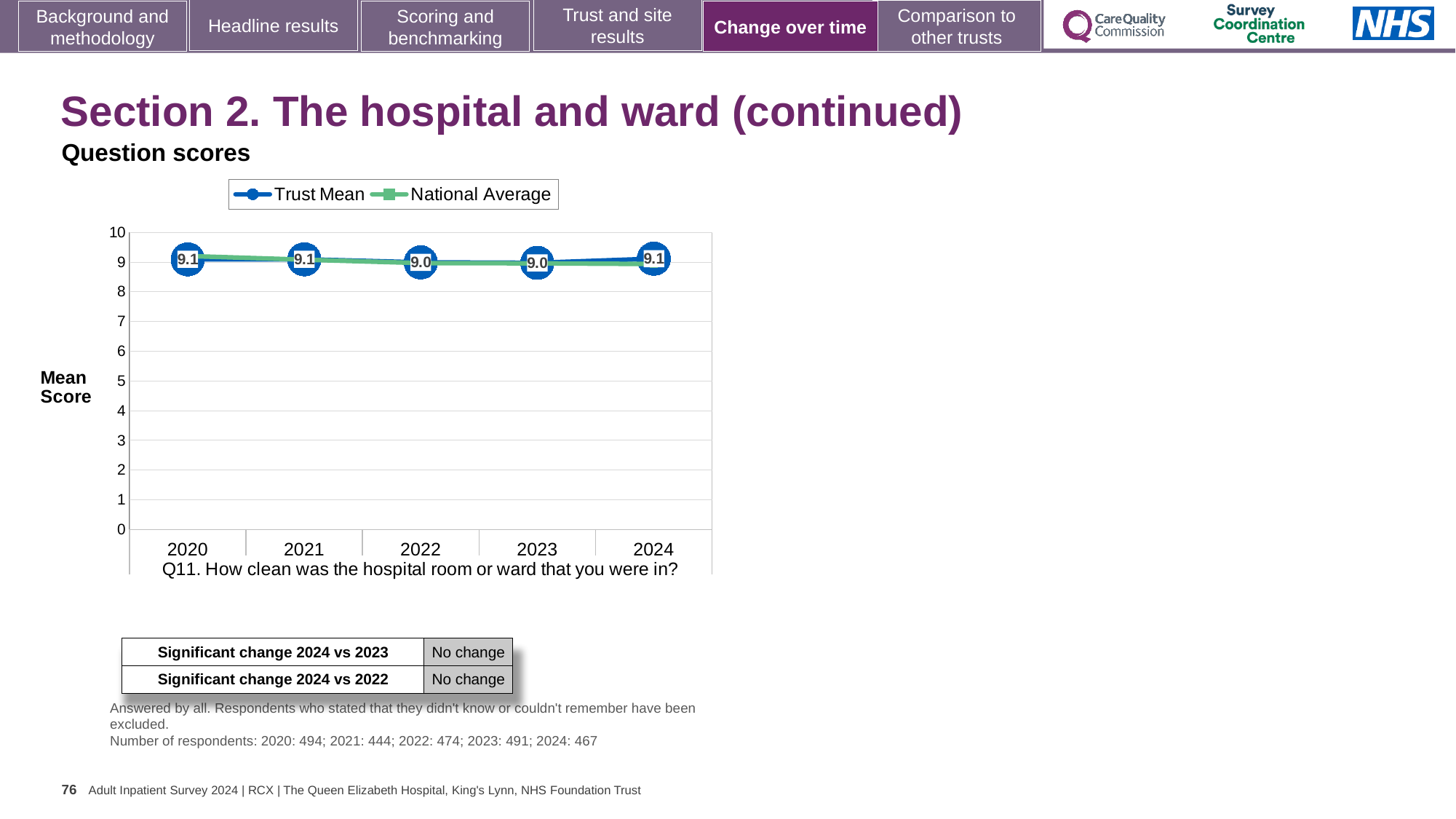
What is the difference between the Trust Mean values for 2020 and 2022? 0.1 Which year has the larger Trust Mean value, 2021 or 2022? 2021 What is the highest Trust Mean value shown on the chart? 9.1 Is the Trust Mean value for 2023 greater or less than 5? greater How many years are plotted on the x axis? 5 Which survey question does the chart show scores for? Q11. How clean was the hospital room or ward that you were in? How many series does the legend list? 2 What kind of chart is shown on the slide? Line chart What is the Trust Mean value for 2022? 9.0 What is the Trust Mean value for 2024? 9.1 What is the Trust Mean value for 2020? 9.1 What is the Trust Mean value for 2023? 9.0